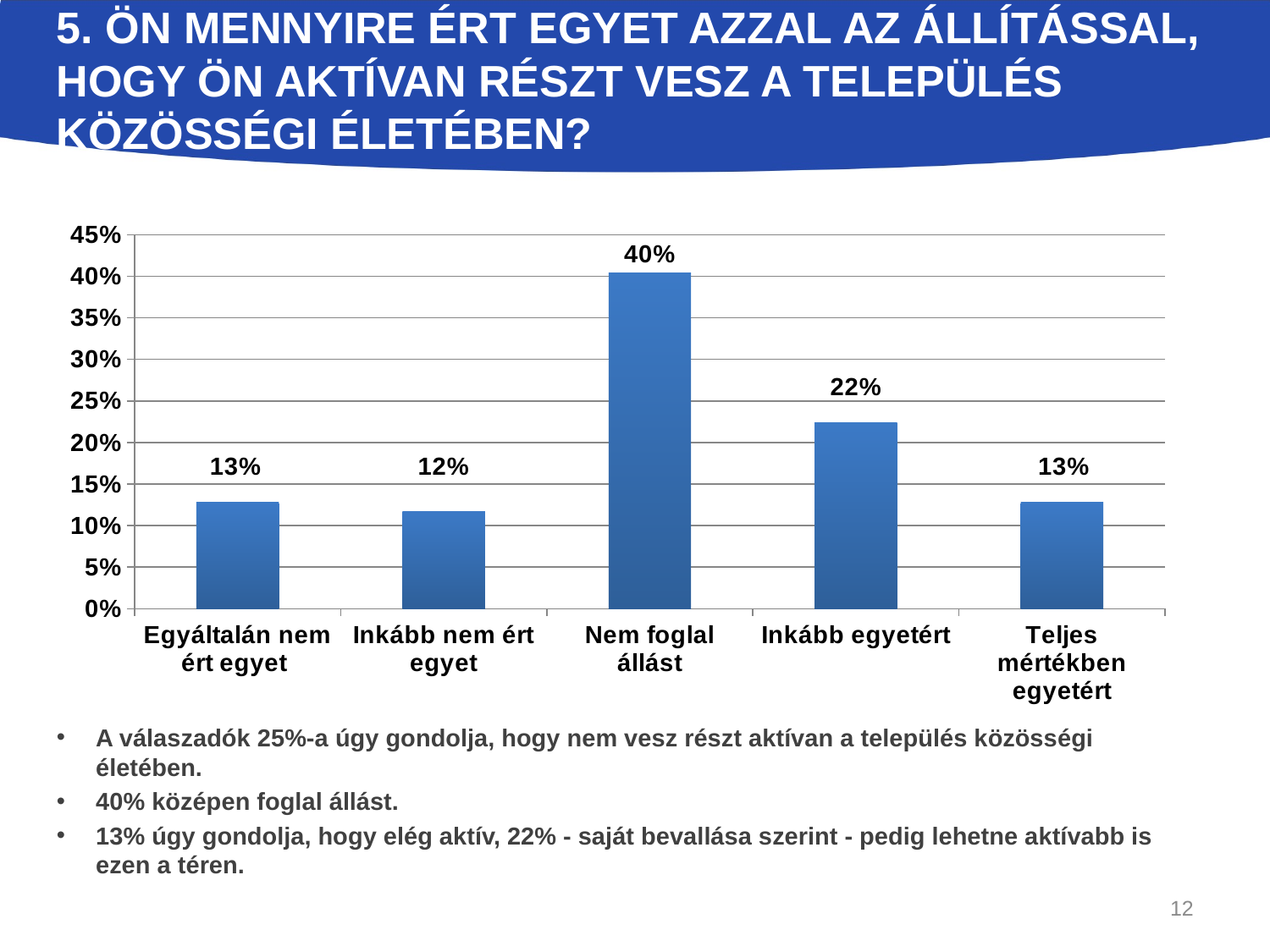
What is the value for "Inkább egyetért"? 22% What is the value for "Inkább nem ért egyet"? 12% Which is larger, the value for "Inkább egyetért" or the value for "Egyáltalán nem ért egyet"? Inkább egyetért Which category has the highest value? Nem foglal állást What is the difference between the values for "Nem foglal állást" and "Inkább egyetért"? 18% What kind of chart is shown on the slide? bar chart Is the value for "Nem foglal állást" greater or less than 35%? greater What is the value for "Nem foglal állást"? 40% How many categories are shown on the x axis? 5 What is the highest value shown on the y axis? 45% What is the value for "Teljes mértékben egyetért"? 13% Which category has the lowest value? Inkább nem ért egyet